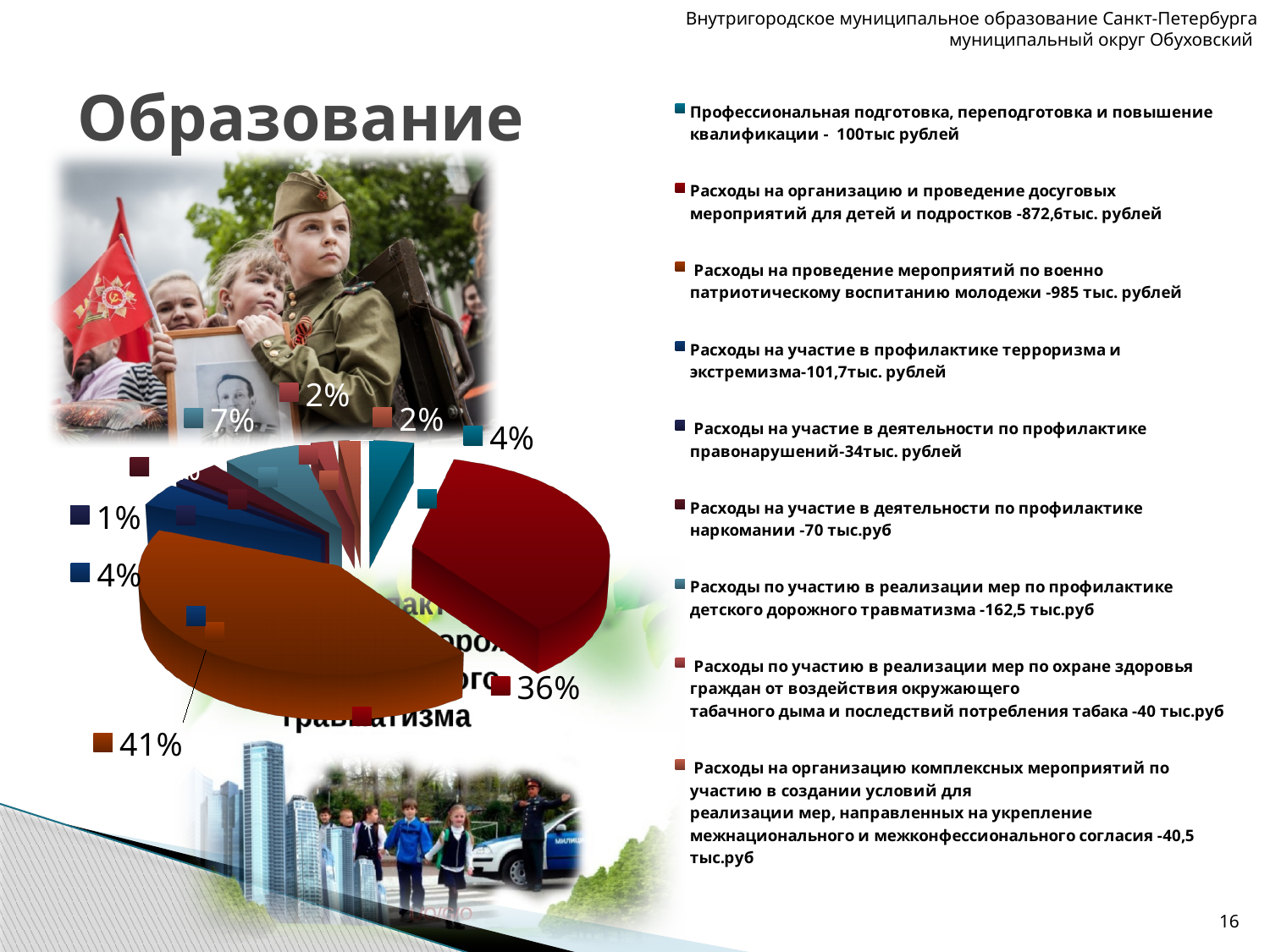
What is the smallest percentage labelled on the pie chart? 1% Which is larger on the pie chart: the slice labelled 36% or the slice labelled 41%? 41% What kind of chart is shown on the slide? pie chart What is the combined share of the two largest slices (41% and 36%) of the pie chart? 77% According to the legend, how much is spent on participation in the prevention of drug addiction (профилактика наркомании)? 70 тыс.руб According to the legend, how much is spent on leisure events for children and teenagers (досуговые мероприятия для детей и подростков)? 872,6 тыс. рублей According to the legend, how much is spent on military-patriotic education of youth (мероприятия по военно патриотическому воспитанию молодежи)? 985 тыс. рублей What is the title of the slide containing the pie chart? Образование What is the largest percentage shown on the pie chart? 41% How many entries does the legend on the right of the slide list? 9 What is the difference between the two largest slices of the pie chart, labelled 41% and 36%? 5% According to the legend, how much is spent on professional training, retraining and advanced qualification (Профессиональная подготовка, переподготовка и повышение квалификации)? 100 тыс рублей